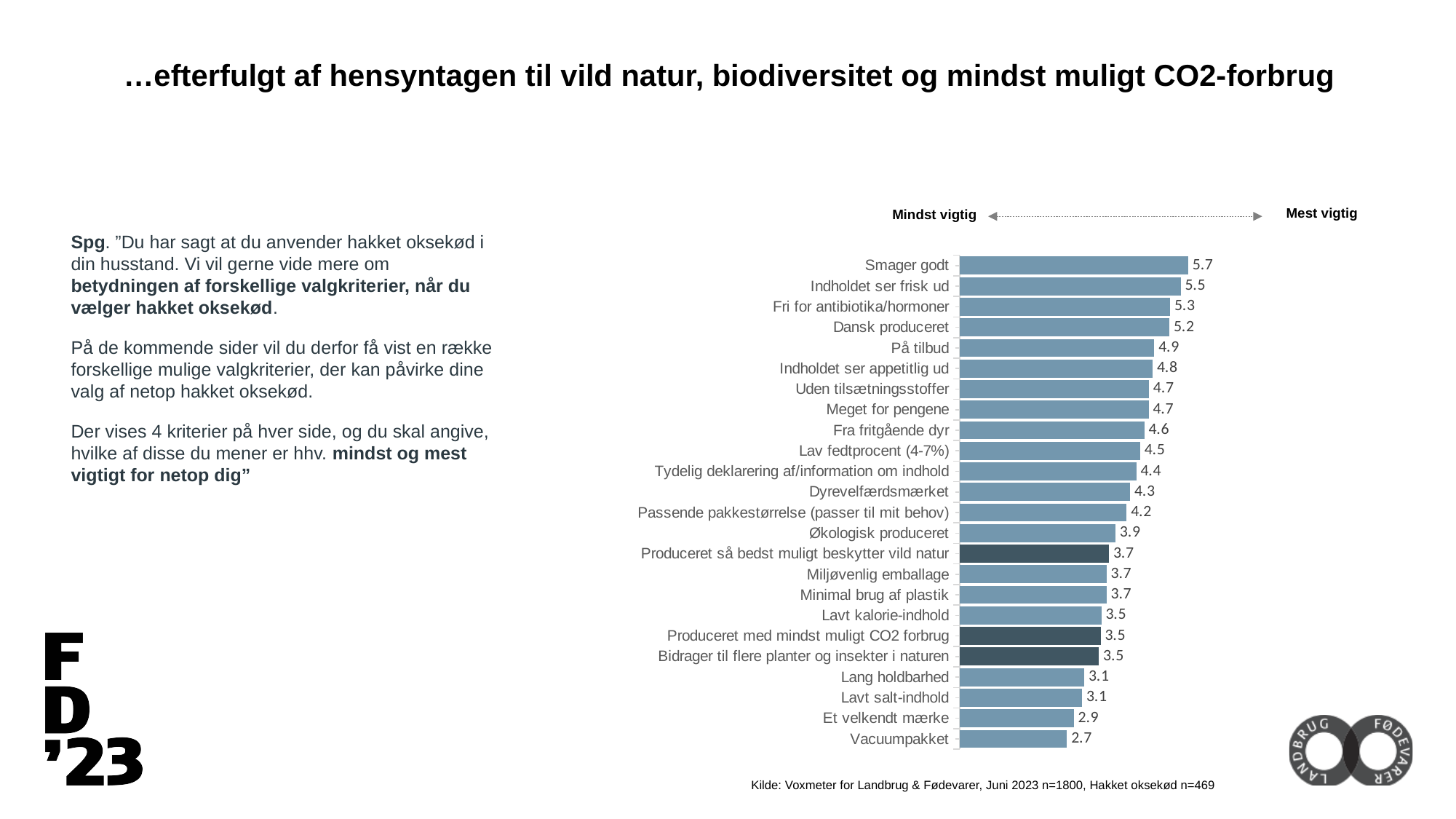
What kind of chart is shown on the slide? Bar chart Which has a larger value, "På tilbud" or "Dyrevelfærdsmærket"? På tilbud How many bars are drawn in a darker colour than the rest? 3 What is the value for "Produceret med mindst muligt CO2 forbrug"? 3.5 What is the value for "Økologisk produceret"? 3.9 Which category has the highest value? Smager godt What is the value for "Dansk produceret"? 5.2 How many categories are shown in the chart? 24 What is the difference between the values for "Smager godt" and "Vacuumpakket"? 3.0 Which category has the lowest value? Vacuumpakket What is the value for "Smager godt"? 5.7 What is the difference between the values for "Fri for antibiotika/hormoner" and "Et velkendt mærke"? 2.4